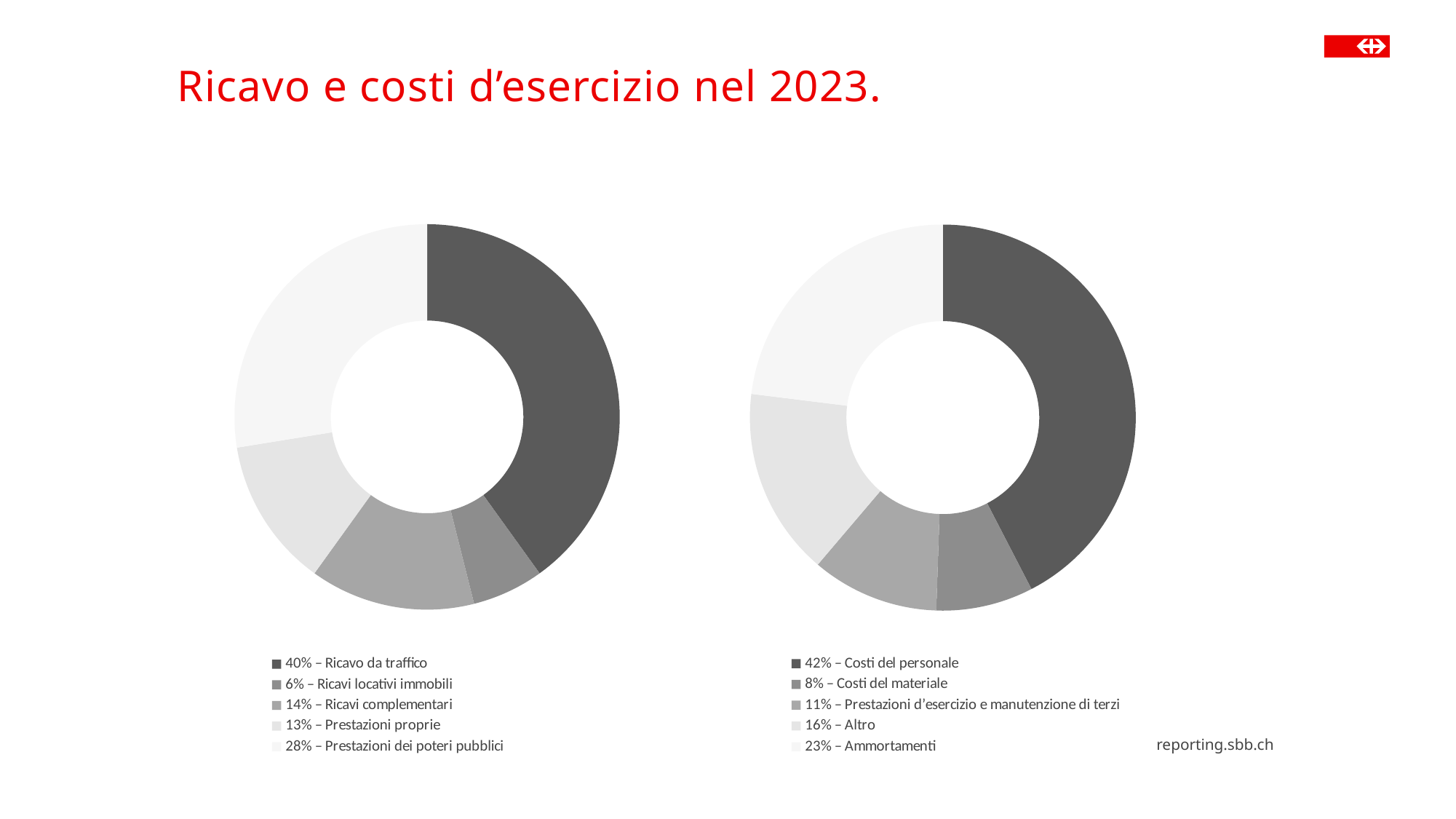
What kind of chart is the left chart? Doughnut (pie) chart In the right chart, which category has the smallest share? Costi del materiale In the left chart, which category has the smallest share? Ricavi locativi immobili In the right chart, what share is Ammortamenti? 23% In the left chart, what share is Ricavo da traffico? 40% In the left chart, which is larger: Ricavi complementari or Prestazioni proprie? Ricavi complementari In the right chart, what is the difference between Altro and Prestazioni d'esercizio e manutenzione di terzi? 5 percentage points In the right chart, what share is Costi del personale? 42% In the left chart, what is the difference between Ricavo da traffico and Prestazioni dei poteri pubblici? 12 percentage points How many categories does the right chart's legend list? 5 In the right chart, which category has the largest share? Costi del personale